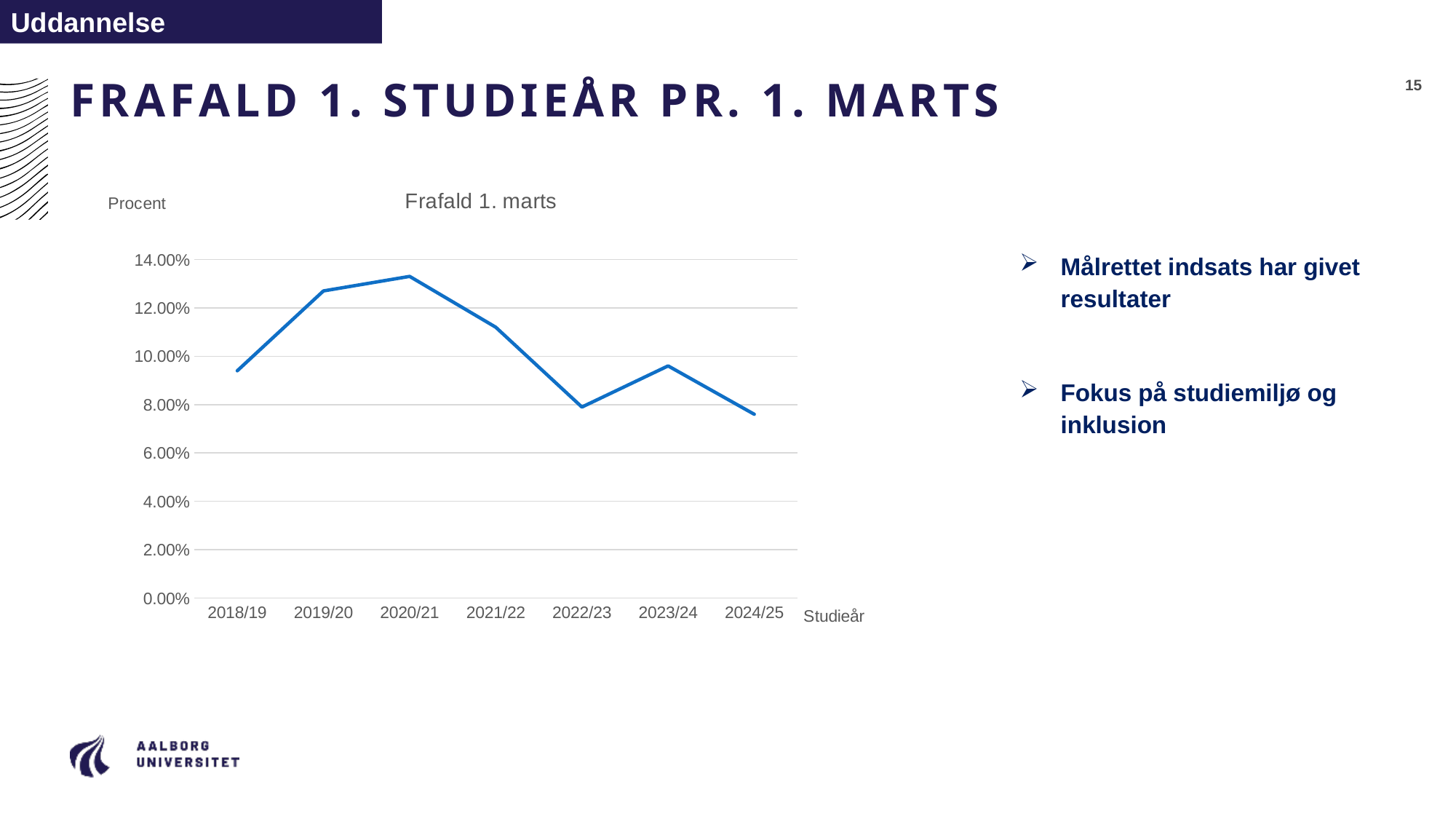
Is the value for 2018/19 greater or less than 10.00%? less How many study years are plotted on the x axis of the chart? 7 Which study year has the highest dropout rate in the chart? 2020/21 Does the dropout rate rise or fall from 2020/21 to 2022/23? fall Which is larger, the value for 2019/20 or the value for 2021/22? 2019/20 Is the value for 2023/24 greater or less than 8.00%? greater Is the value for 2020/21 greater or less than 12.00%? greater What kind of chart is shown on the slide? line chart What label is shown on the x axis of the chart? Studieår What is the title of the chart? Frafald 1. marts